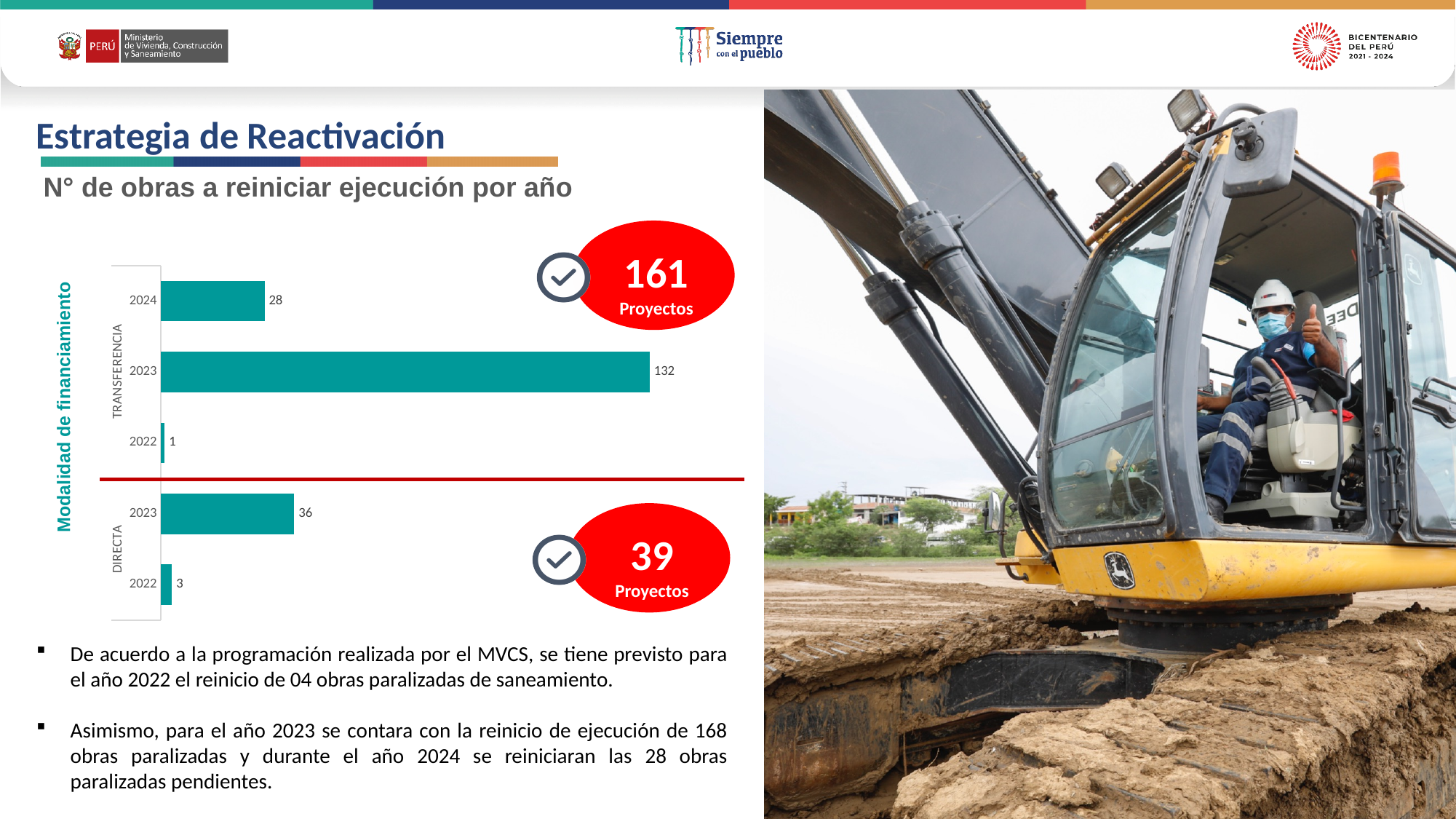
Which is larger: the 2023 value under DIRECTA or the 2024 value under TRANSFERENCIA? 2023 under DIRECTA What is the value for 2023 under DIRECTA? 36 How many bars are plotted in the chart? 5 What is the value for 2024 under TRANSFERENCIA? 28 What is the difference between the 2023 and 2024 values under TRANSFERENCIA? 104 What is the total of the DIRECTA bars (2022 and 2023)? 39 What kind of chart is shown on the slide? Bar chart Which bar has the lowest value in the chart? 2022 (TRANSFERENCIA) What is the label on the vertical axis of the chart? Modalidad de financiamiento Which bar has the highest value in the chart? 2023 (TRANSFERENCIA) What is the value for 2022 under DIRECTA? 3 What is the value for 2023 under TRANSFERENCIA? 132